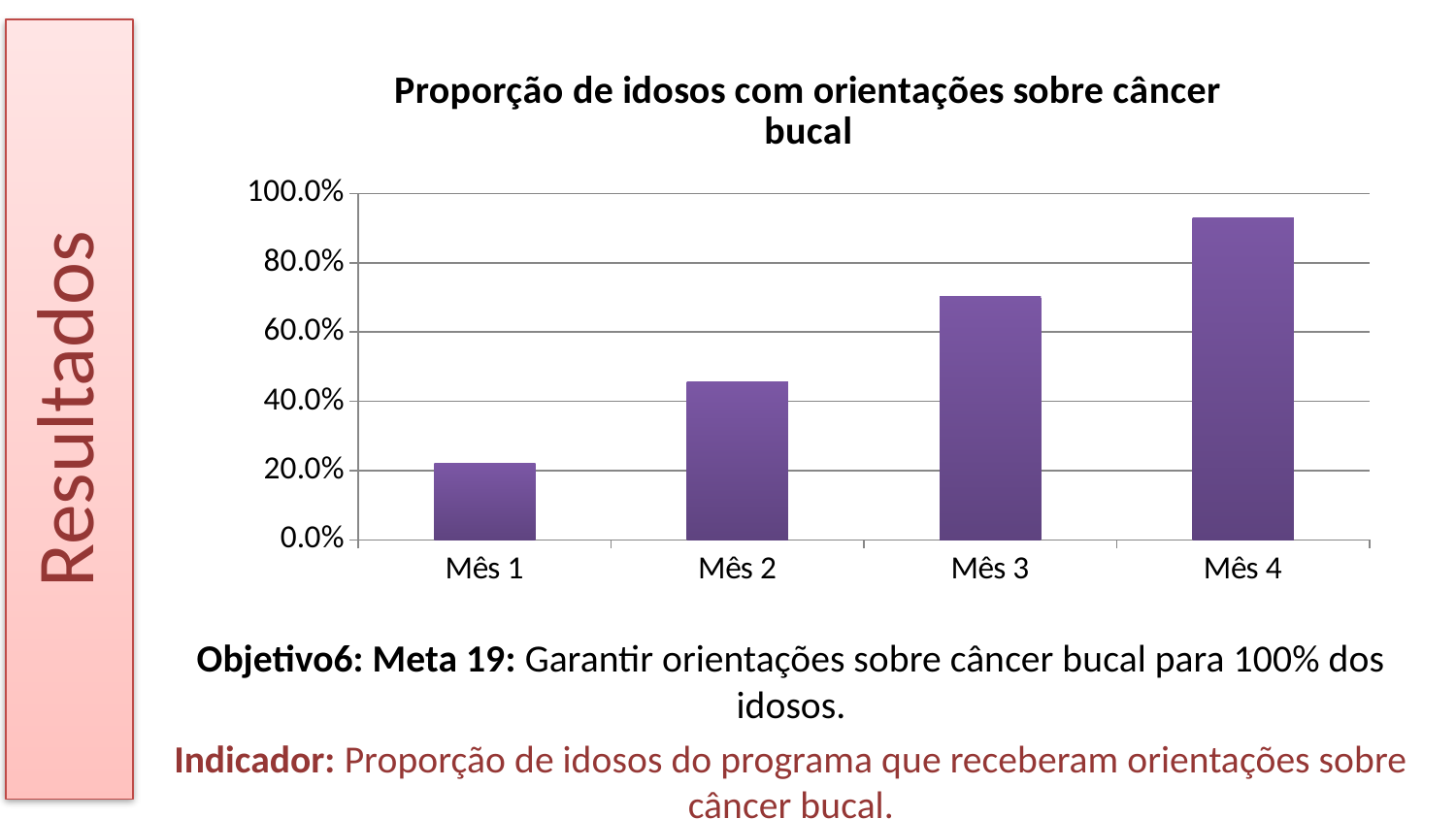
Which is larger, the value for Mês 2 or the value for Mês 3? Mês 3 Is the value for Mês 1 greater or less than 40.0%? less Is the value for Mês 3 greater or less than 80.0%? less What type of chart is shown on the slide? bar chart What is the maximum value shown on the y axis of the chart? 100.0% Do the values rise or fall from Mês 1 to Mês 4? rise How many categories (months) are shown on the x axis of the chart? 4 Which month has the lowest proportion in the chart? Mês 1 Is the value for Mês 2 greater or less than 40.0%? greater What is the title of the chart? Proporção de idosos com orientações sobre câncer bucal Which month has the highest proportion in the chart? Mês 4